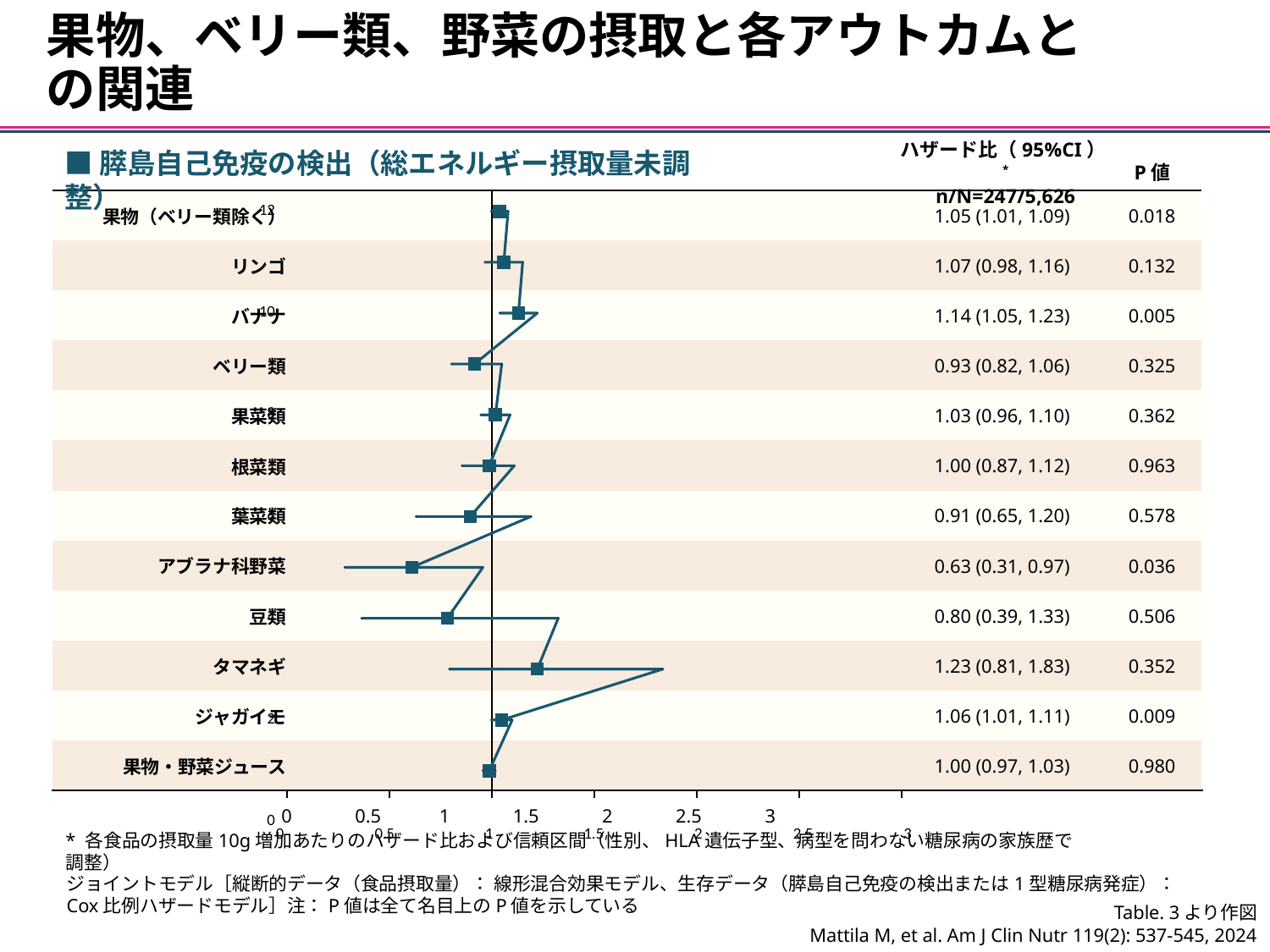
How many foods are plotted in the chart? 12 Is the hazard ratio for 豆類 greater or less than 1? less What is the P value for ジャガイモ? 0.009 What is the difference between the hazard ratios for バナナ and 果物（ベリー類除く）? 0.09 Which food has the highest hazard ratio? タマネギ What is the n/N shown for the analysis? 247/5,626 What is the hazard ratio for バナナ? 1.14 What is the 95% CI for アブラナ科野菜? (0.31, 0.97) Which food has the lowest hazard ratio? アブラナ科野菜 What kind of chart is shown on the slide? forest plot Which has the larger hazard ratio, ベリー類 or リンゴ? リンゴ What is the hazard ratio for 果物・野菜ジュース? 1.00